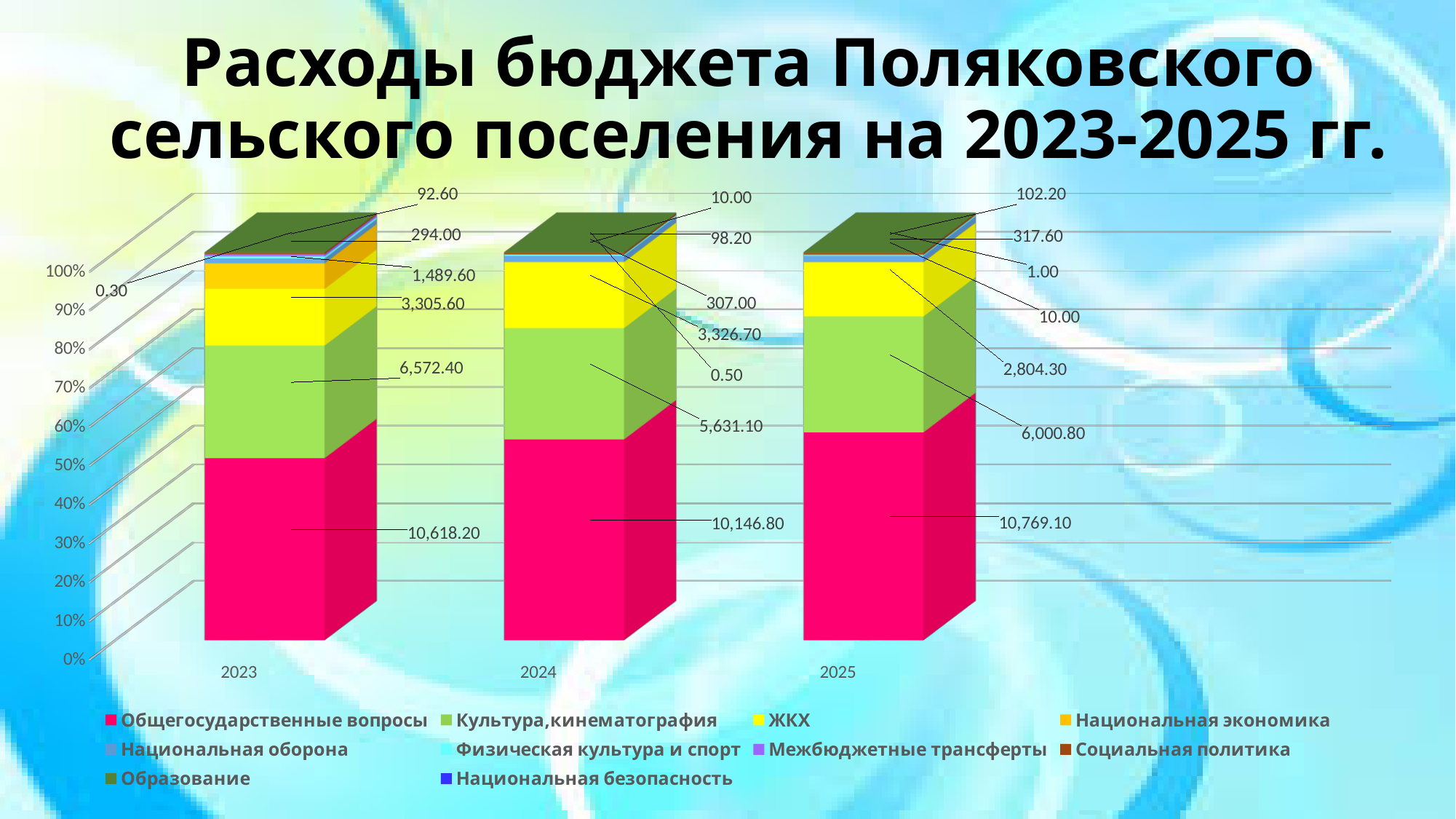
What is the value for ЖКХ in 2025? 2,804.30 What kind of chart is shown on the slide? Stacked bar chart What is the value for Культура,кинематография in 2024? 5,631.10 In which year is the value for Культура,кинематография the lowest? 2024 How many series does the legend list? 10 What is the value for Общегосударственные вопросы in 2023? 10,618.20 What is the difference between the ЖКХ values for 2024 and 2025? 522.40 In which year is the value for Общегосударственные вопросы the highest? 2025 What is the value for Национальная экономика in 2023? 1,489.60 How many years are shown on the x axis? 3 What is the difference between the Общегосударственные вопросы values for 2025 and 2024? 622.30 Which is larger: ЖКХ in 2023 or ЖКХ in 2024? ЖКХ in 2024